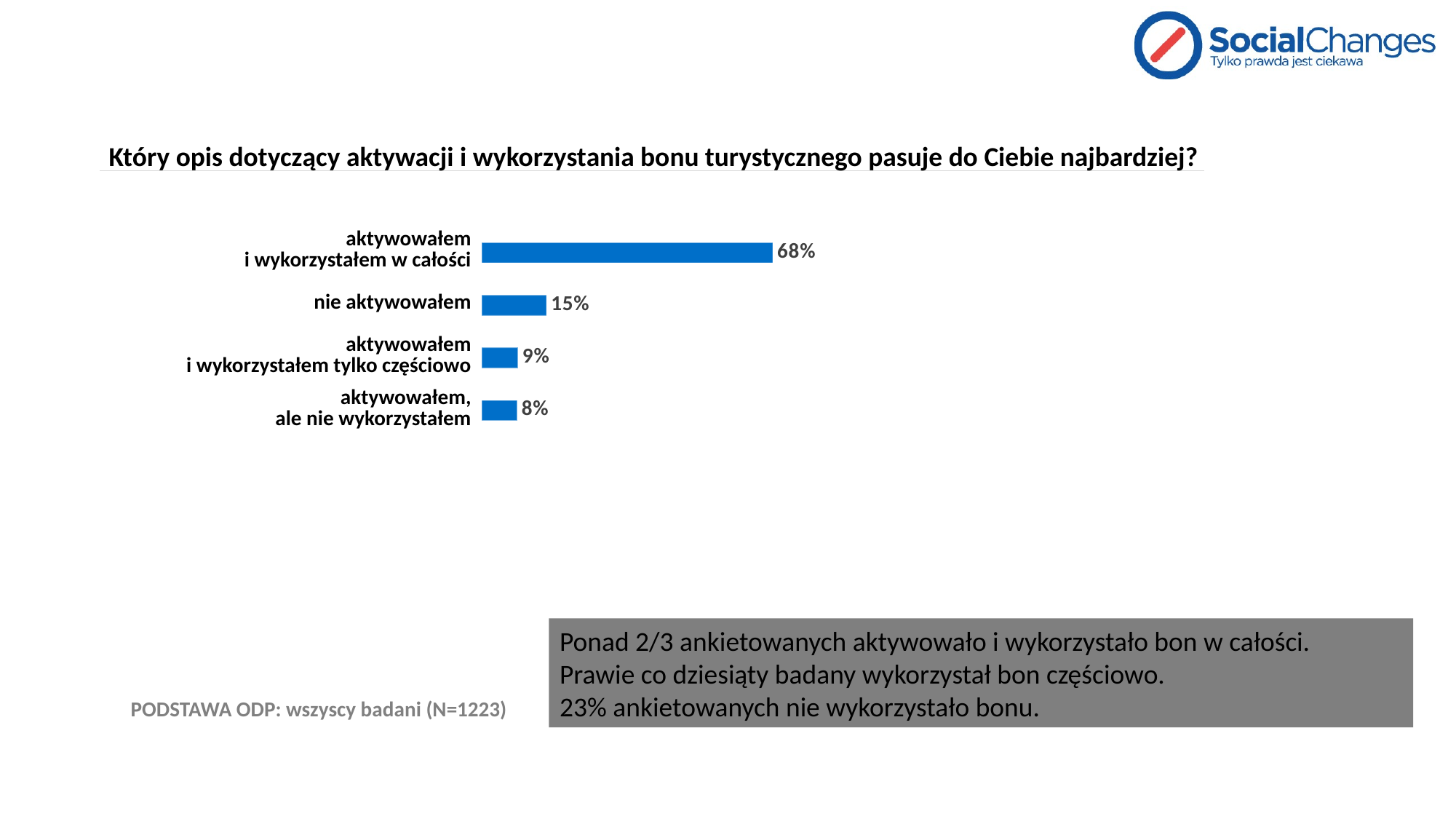
Which is larger: the value for "nie aktywowałem" or for "aktywowałem i wykorzystałem tylko częściowo"? nie aktywowałem What is the difference between the values for "aktywowałem i wykorzystałem w całości" and "nie aktywowałem"? 53% Which category has the lowest value? aktywowałem, ale nie wykorzystałem What is the difference between the values for "nie aktywowałem" and "aktywowałem, ale nie wykorzystałem"? 7% What is the value for "aktywowałem i wykorzystałem tylko częściowo"? 9% What is the value for "aktywowałem i wykorzystałem w całości"? 68% What is the value for "nie aktywowałem"? 15% What is the sample size (N) stated at the bottom of the slide? N=1223 Which category has the highest value? aktywowałem i wykorzystałem w całości What is the value for "aktywowałem, ale nie wykorzystałem"? 8% What kind of chart is shown on the slide? bar chart How many categories are shown in the chart? 4